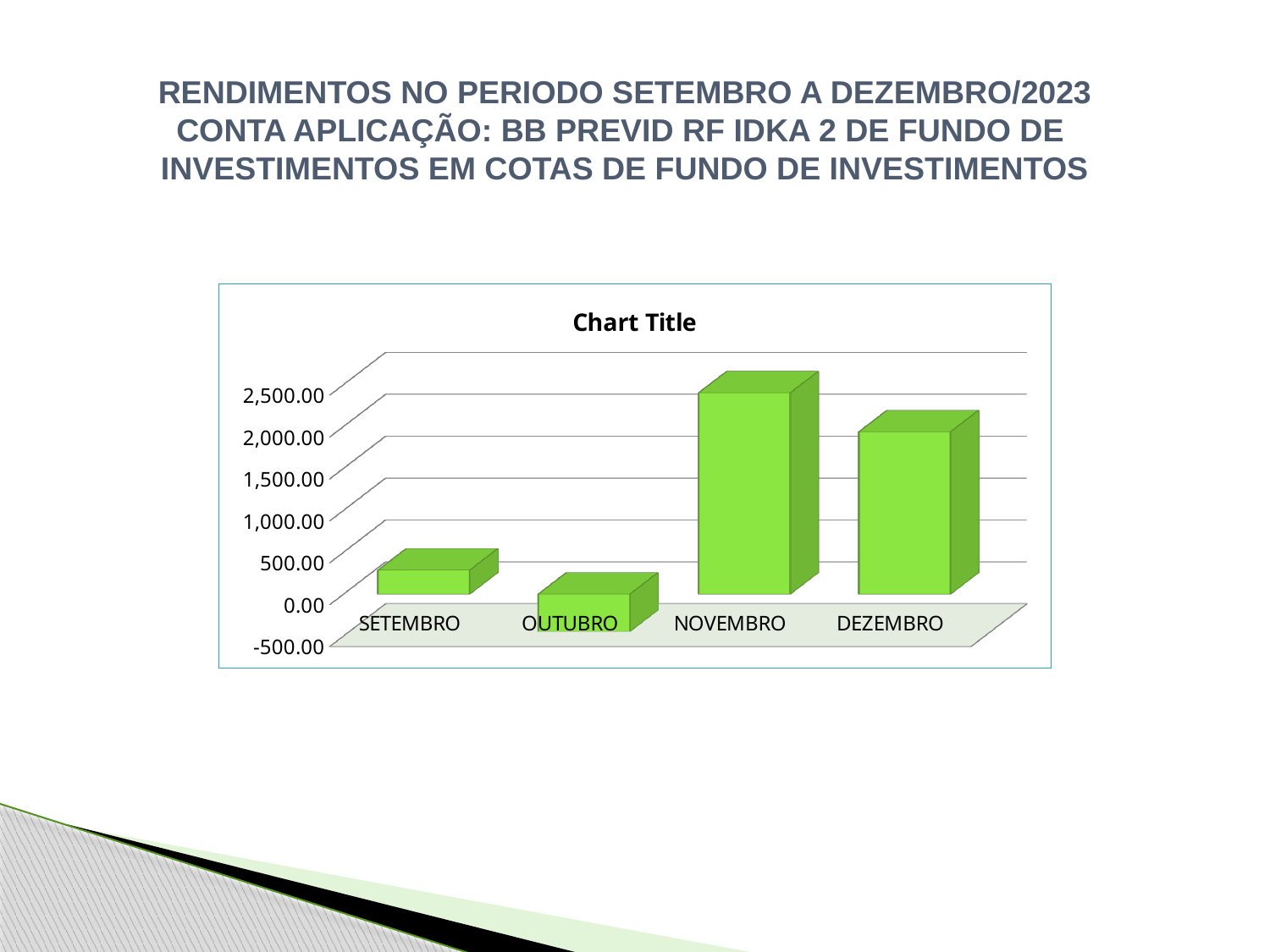
Is the value for OUTUBRO greater or less than 500.00? less Is the value for DEZEMBRO greater or less than 1,500.00? greater Is the value for SETEMBRO greater or less than 1,000.00? less How many categories are plotted on the x axis of the chart? 4 What colour are the bars in the chart? Green Which month has the highest value in the chart? NOVEMBRO Which is larger, the value for SETEMBRO or the value for OUTUBRO? SETEMBRO Which is larger, the value for NOVEMBRO or the value for DEZEMBRO? NOVEMBRO What kind of chart is shown on the slide? Bar chart What is the title shown inside the chart area? Chart Title Which month has the lowest value in the chart? OUTUBRO